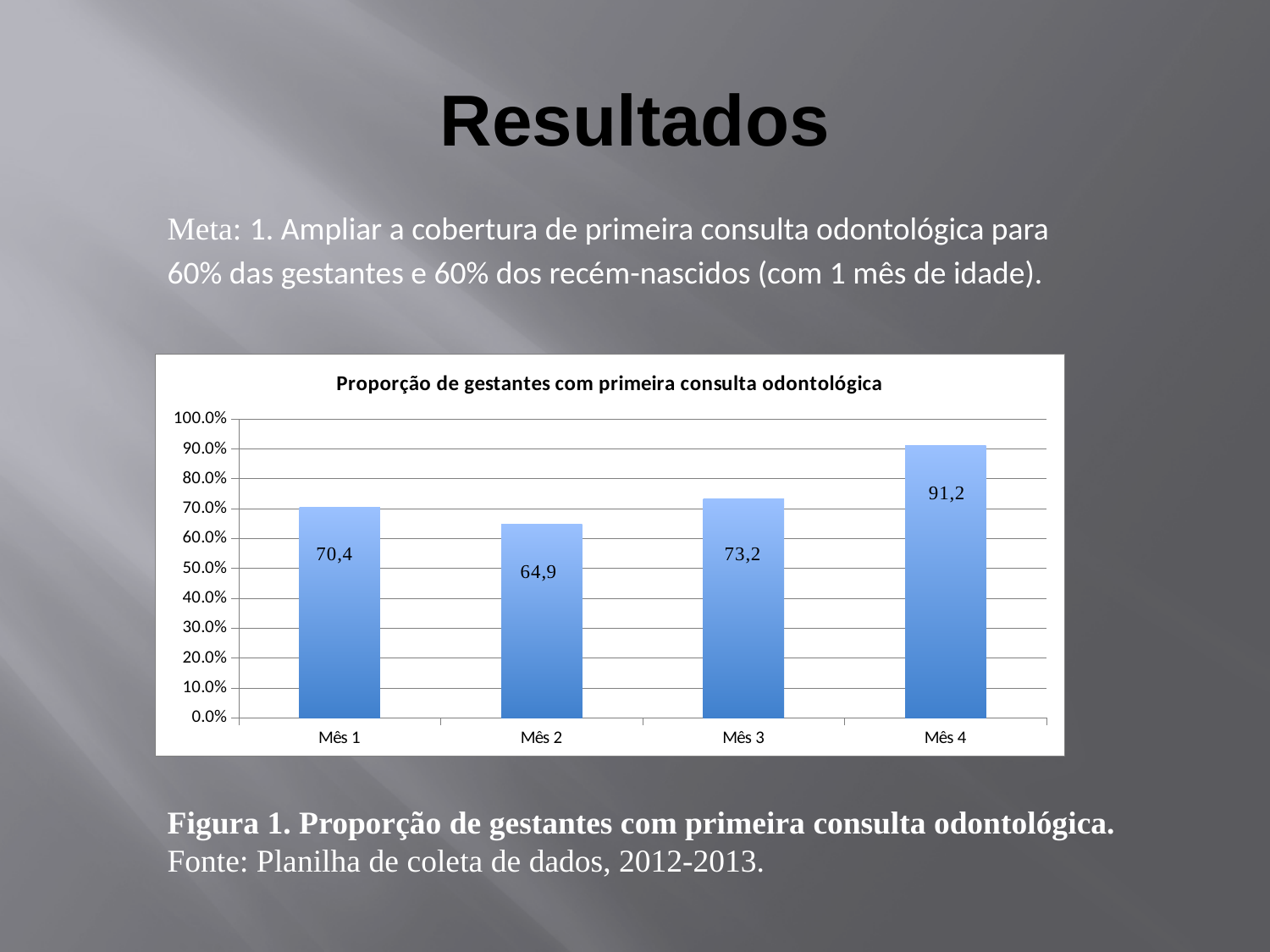
What is the title of the chart? Proporção de gestantes com primeira consulta odontológica How many months are shown on the x axis? 4 What is the difference between the values for Mês 4 and Mês 2? 26,3 What is the value shown for Mês 1? 70,4 What is the value shown for Mês 4? 91,2 Is the value for Mês 4 greater or less than 80.0%? greater Which month has the highest proportion? Mês 4 What is the difference between the values for Mês 3 and Mês 1? 2,8 Which is larger, the value for Mês 3 or the value for Mês 1? Mês 3 What is the value shown for Mês 2? 64,9 Which month has the lowest proportion? Mês 2 What kind of chart is shown? Bar chart